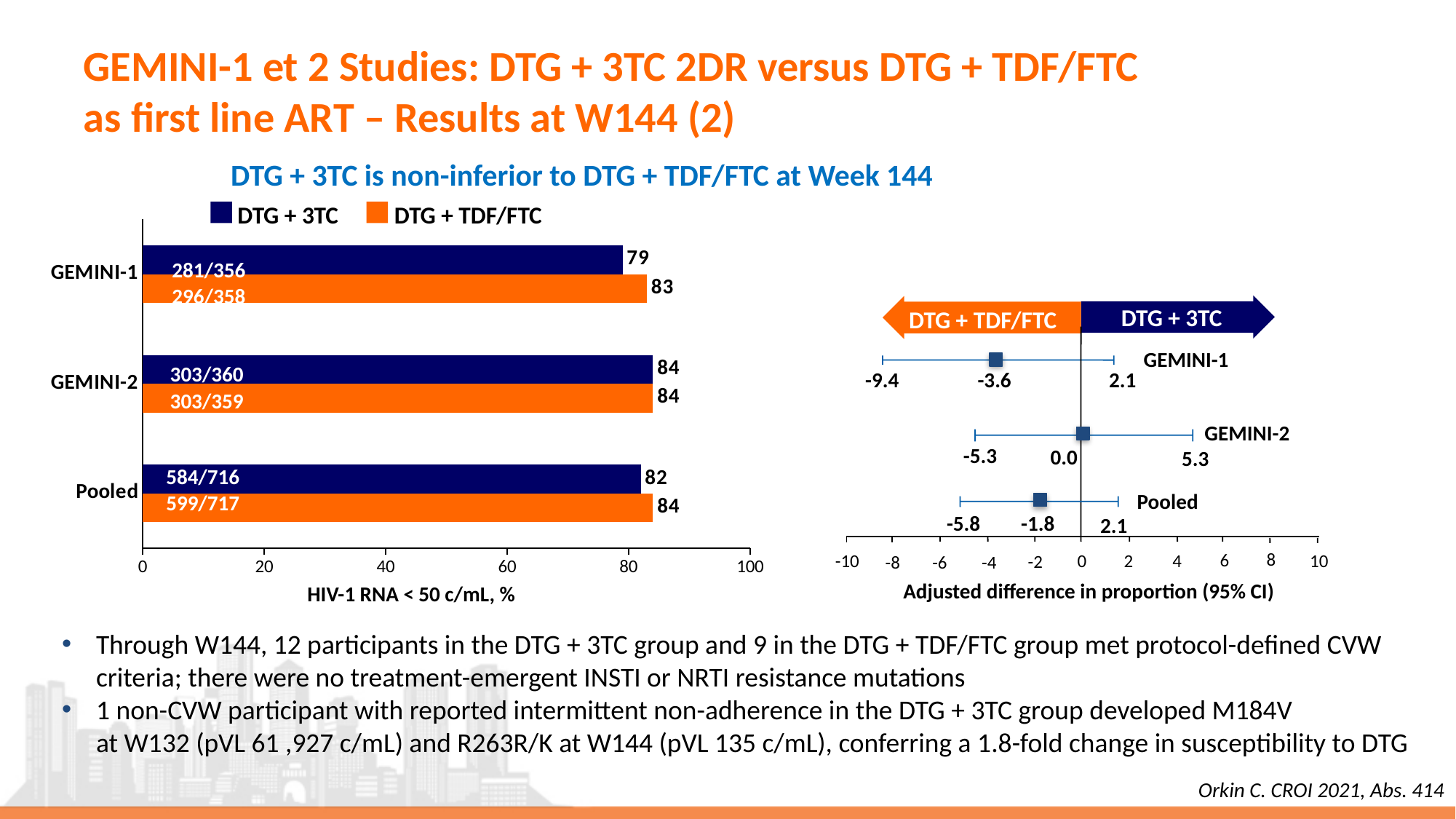
In the left bar chart, how many categories are shown? 3 What is the x-axis label of the left bar chart? HIV-1 RNA < 50 c/mL, % In the left bar chart, what is the value for DTG + 3TC in GEMINI-1? 79 In the left bar chart, which category has the lowest value for DTG + 3TC? GEMINI-1 In the left bar chart, what is the difference between the DTG + TDF/FTC and DTG + 3TC values for GEMINI-1? 4 What kind of chart is the chart on the left? Bar chart In the right chart, what is the adjusted difference in proportion for GEMINI-1? -3.6 In the right chart, what is the adjusted difference in proportion for Pooled? -1.8 In the left bar chart, what is the value for DTG + TDF/FTC in the Pooled category? 84 In the left bar chart, what is the value for DTG + TDF/FTC in GEMINI-1? 83 In the right chart, what is the upper limit of the 95% CI for GEMINI-2? 5.3 In the left bar chart, how many series does the legend list? 2